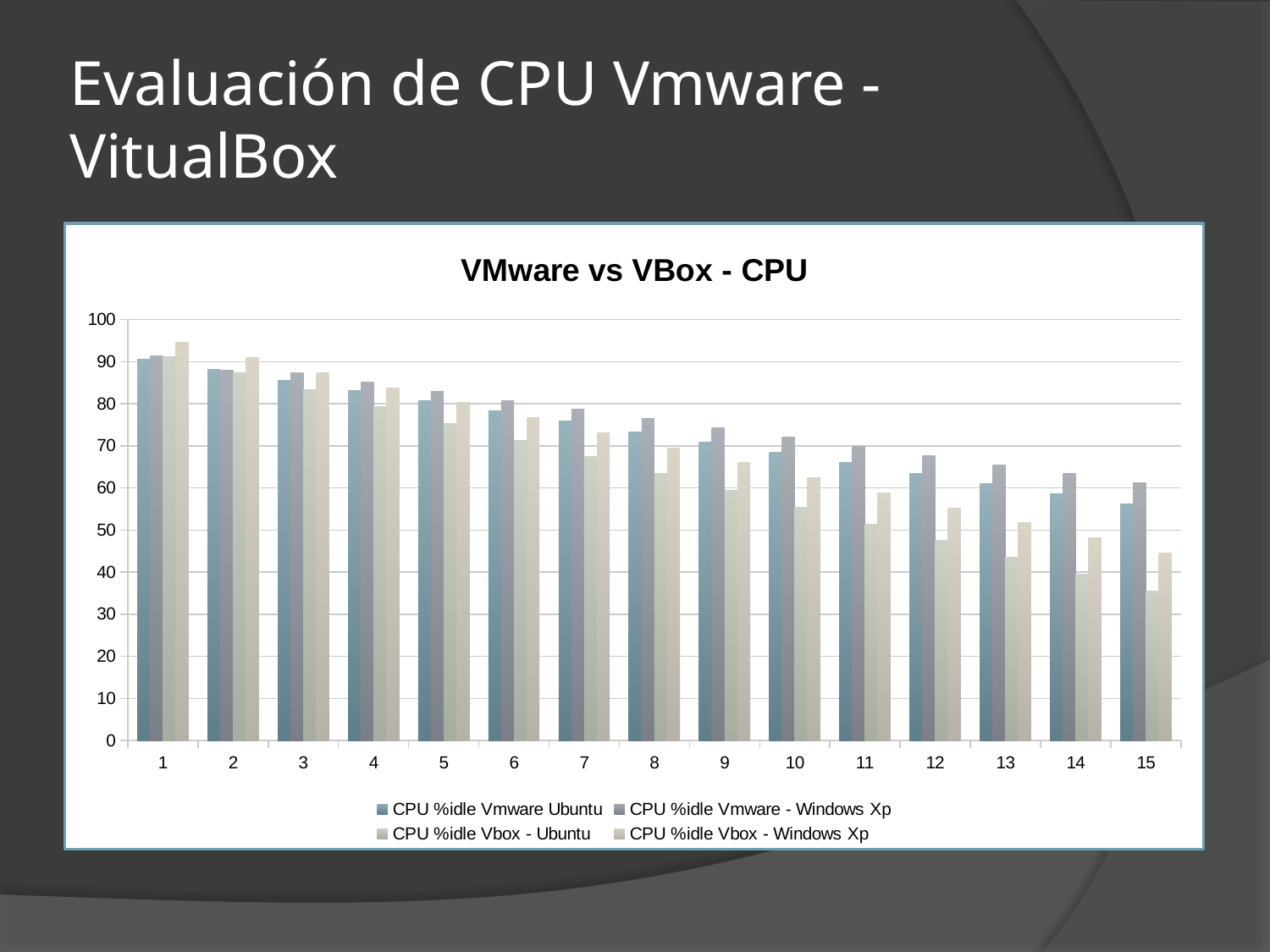
At category 15, which is larger: CPU %idle Vmware - Windows Xp or CPU %idle Vbox - Ubuntu? CPU %idle Vmware - Windows Xp What kind of chart is shown on the slide? bar chart Do the values for CPU %idle Vbox - Ubuntu rise or fall from category 1 to category 15? fall Is the value for CPU %idle Vmware Ubuntu at category 15 greater or less than 50? greater How many series does the legend list? 4 Which series has the lowest value at category 15? CPU %idle Vbox - Ubuntu Is the value for CPU %idle Vbox - Ubuntu at category 13 greater or less than 50? less Is the value for CPU %idle Vbox - Windows Xp at category 1 greater or less than 90? greater What is the title of the chart? VMware vs VBox - CPU Which series has the highest value at category 1? CPU %idle Vbox - Windows Xp How many categories are shown along the x axis? 15